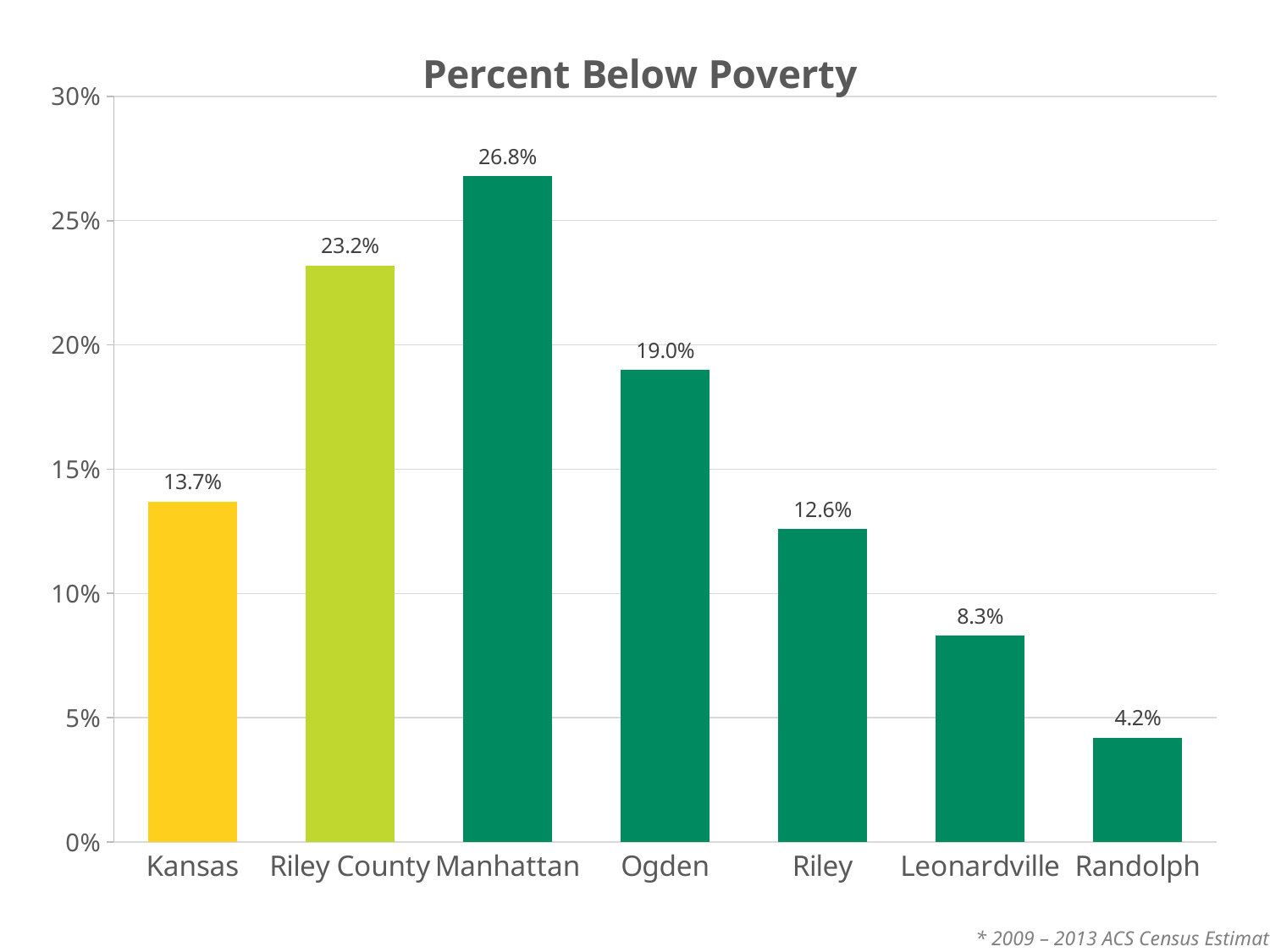
Which has a higher percent below poverty, Kansas or Riley? Kansas What is the title of the chart? Percent Below Poverty What is the percent below poverty for Leonardville? 8.3% Is the value for Ogden greater or less than 20%? less What is the difference in percent below poverty between Riley County and Kansas? 9.5% What is the percent below poverty for Kansas? 13.7% What is the difference in percent below poverty between Ogden and Riley? 6.4% How many categories are shown on the x axis? 7 What kind of chart is shown on the slide? Bar chart Which category has the lowest percent below poverty? Randolph Which category has the highest percent below poverty? Manhattan What is the percent below poverty for Manhattan? 26.8%